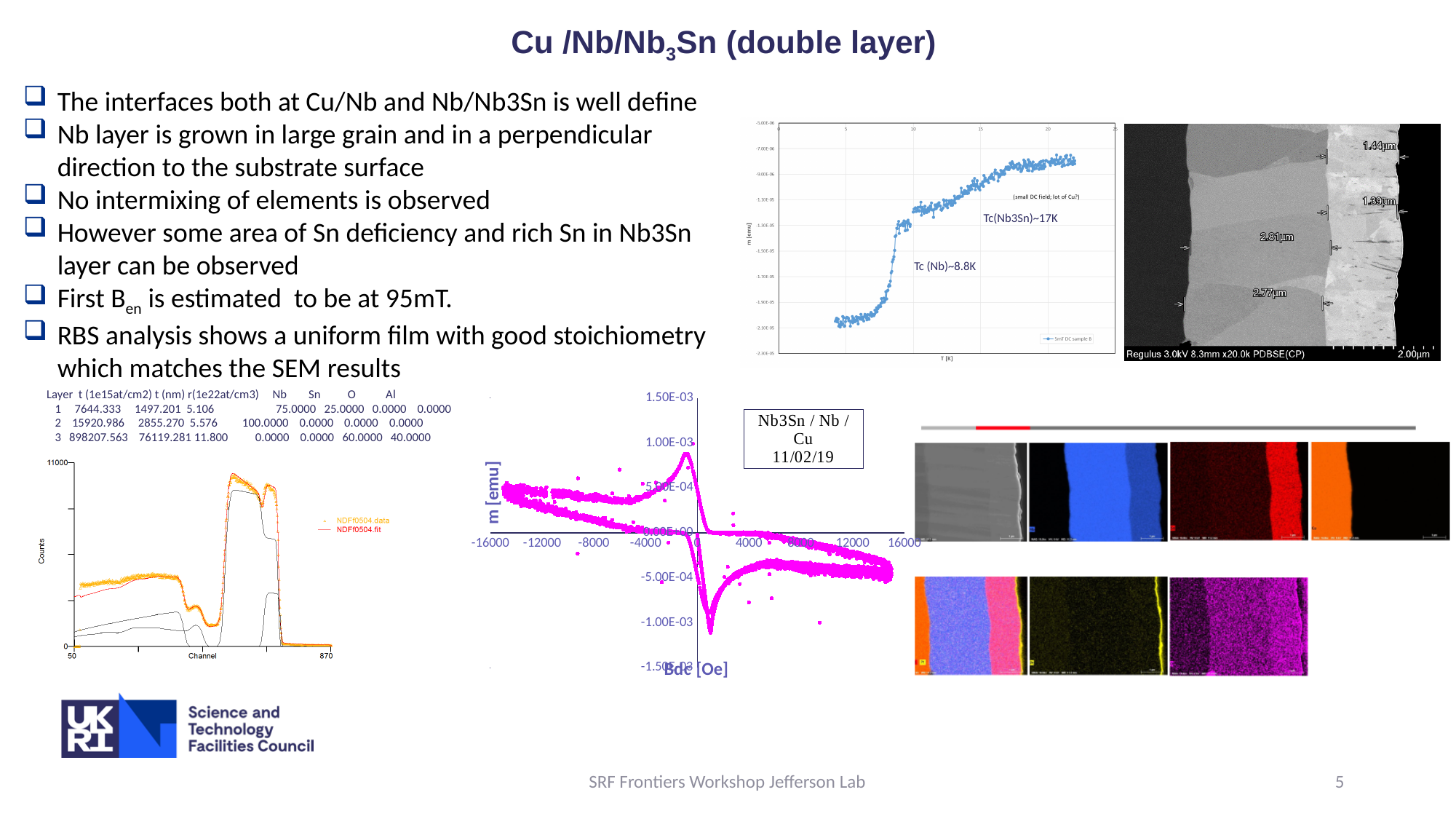
In the bottom-left Counts vs Channel chart, what is the maximum value shown on the Counts axis? 11000 In the top-right m [emu] vs T [K] chart, what Tc value is annotated for Nb3Sn? ~17K In the middle hysteresis chart, what is the largest value shown on the Bdc [Oe] axis? 16000 In the bottom-left Counts vs Channel chart, what are the two legend entries? NDFf0504.data and NDFf0504.fit In the top-right m [emu] vs T [K] chart, what Tc value is annotated for Nb? ~8.8K In the top-right m [emu] vs T [K] chart, what is the legend entry? SmT DC sample B In the bottom-left Counts vs Channel chart, what are the first and last Channel values shown on the x axis? 50 and 870 In the bottom-left Counts vs Channel chart, how many series does the legend list? 2 In the top-right m [emu] vs T [K] chart, does the plotted moment rise or fall as temperature increases? rise In the middle hysteresis chart, what is the highest tick shown on the m [emu] axis? 1.50E-03 In the middle hysteresis chart, what is the smallest value shown on the Bdc [Oe] axis? -16000 What kind of chart is the middle chart with Bdc [Oe] on the x axis? scatter chart